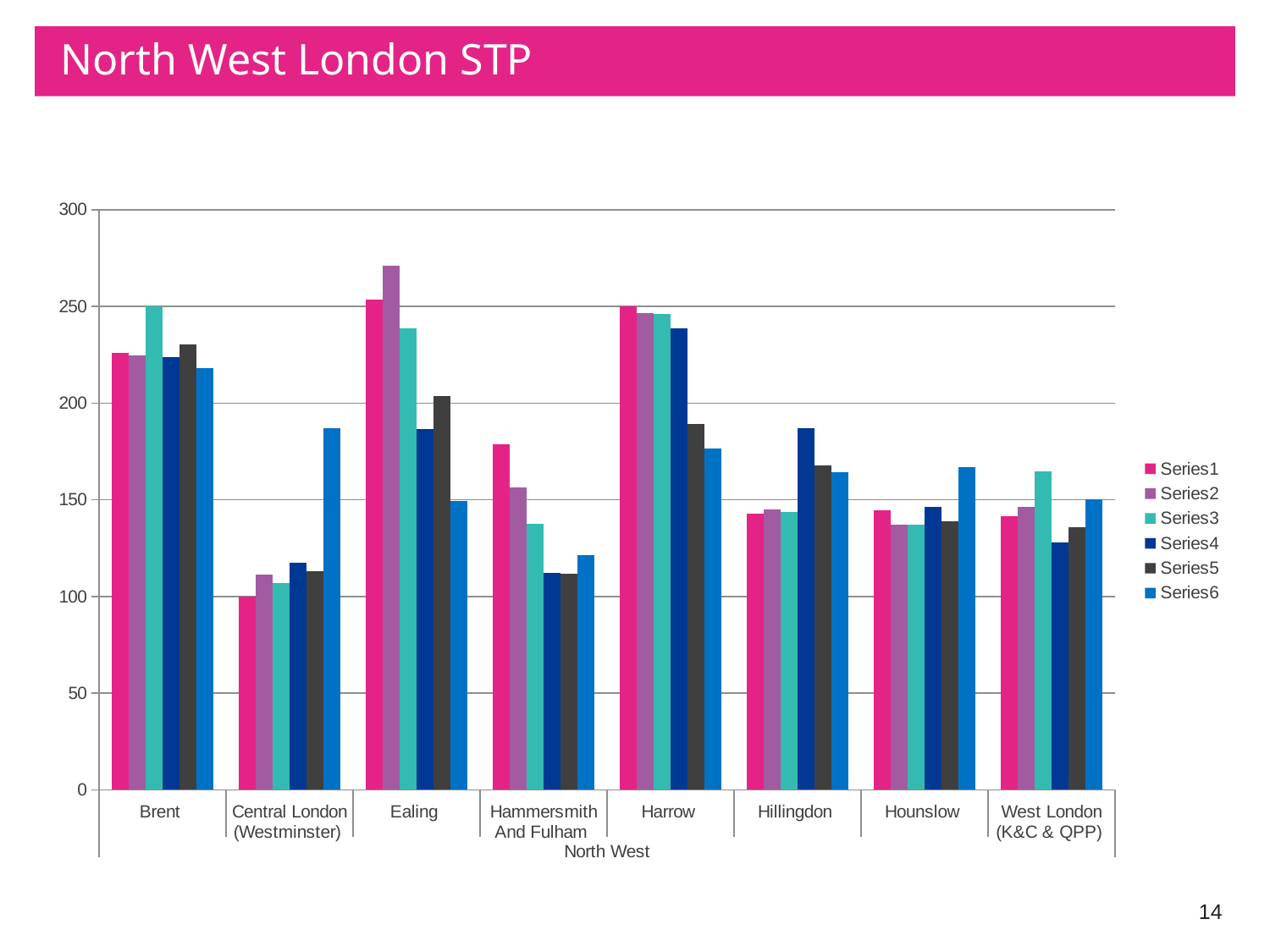
Which is larger: the Series1 value for Hammersmith And Fulham or the Series1 value for Hillingdon? Hammersmith And Fulham How many categories are shown along the x axis of the chart? 8 Is the Series2 value for Ealing greater or less than 250? greater Is the Series5 value for Harrow greater or less than 200? less Is the Series4 value for Hillingdon greater or less than 150? greater Which category has the lowest Series1 value? Central London (Westminster) Which is larger: the Series6 value for Hounslow or the Series6 value for Hammersmith And Fulham? Hounslow What label appears beneath the category names on the x axis? North West What kind of chart is shown on the slide? bar chart Which category has the highest Series2 value? Ealing How many series does the chart's legend list? 6